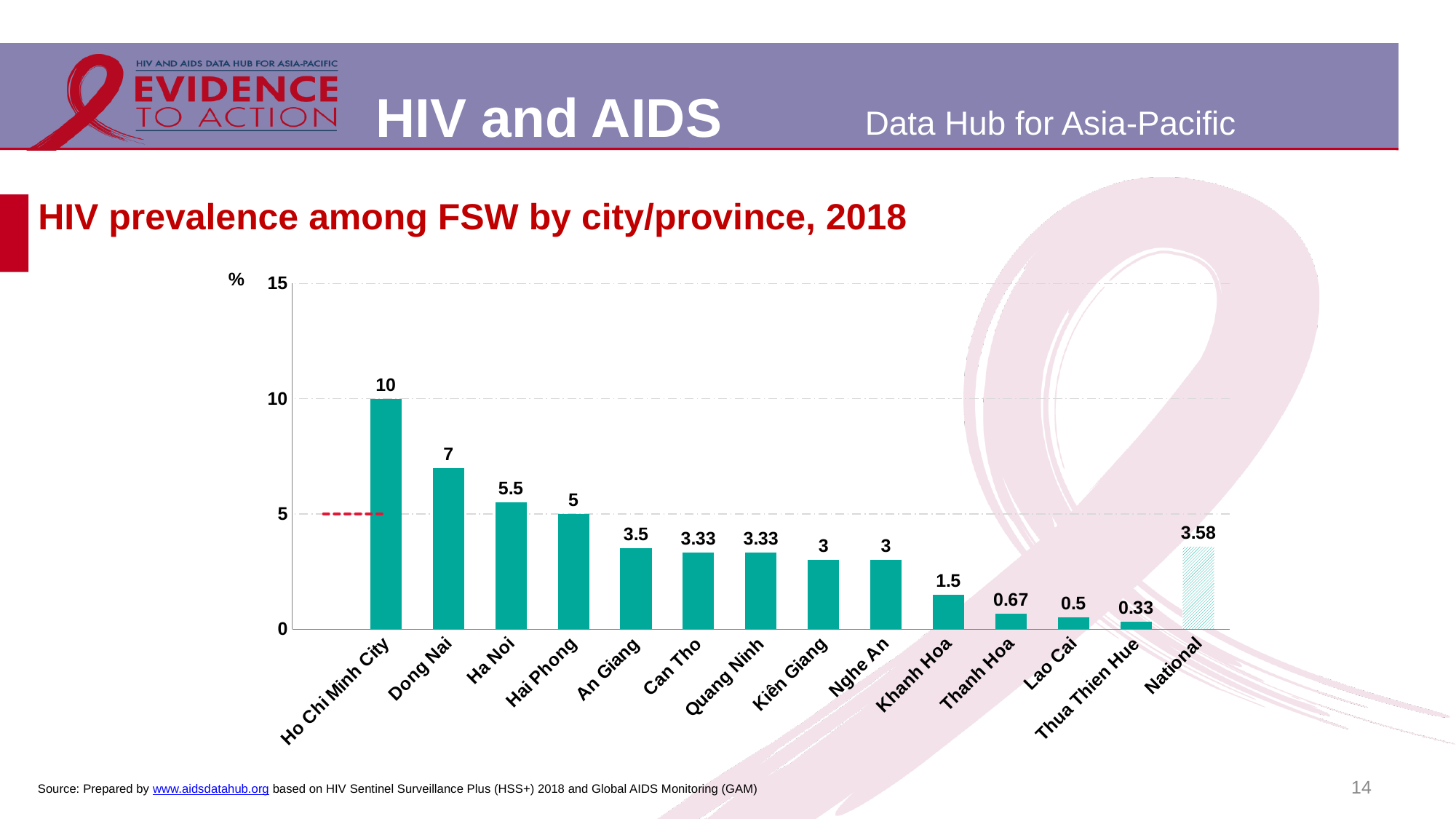
What kind of chart is shown on the slide? Bar chart What is the HIV prevalence among FSW in Ha Noi? 5.5 What is the National HIV prevalence among FSW shown on the chart? 3.58 Is the value for Dong Nai greater or less than 5? greater Which city/province has the lowest HIV prevalence among FSW? Thua Thien Hue What is the difference between the values for Ho Chi Minh City and Dong Nai? 3 What is the HIV prevalence among FSW in Ho Chi Minh City? 10 What is the title of the chart? HIV prevalence among FSW by city/province, 2018 Which has a higher value, Hai Phong or An Giang? Hai Phong What is the value for Thua Thien Hue? 0.33 How many bars are plotted on the chart, including National? 14 Which city/province has the highest HIV prevalence among FSW? Ho Chi Minh City